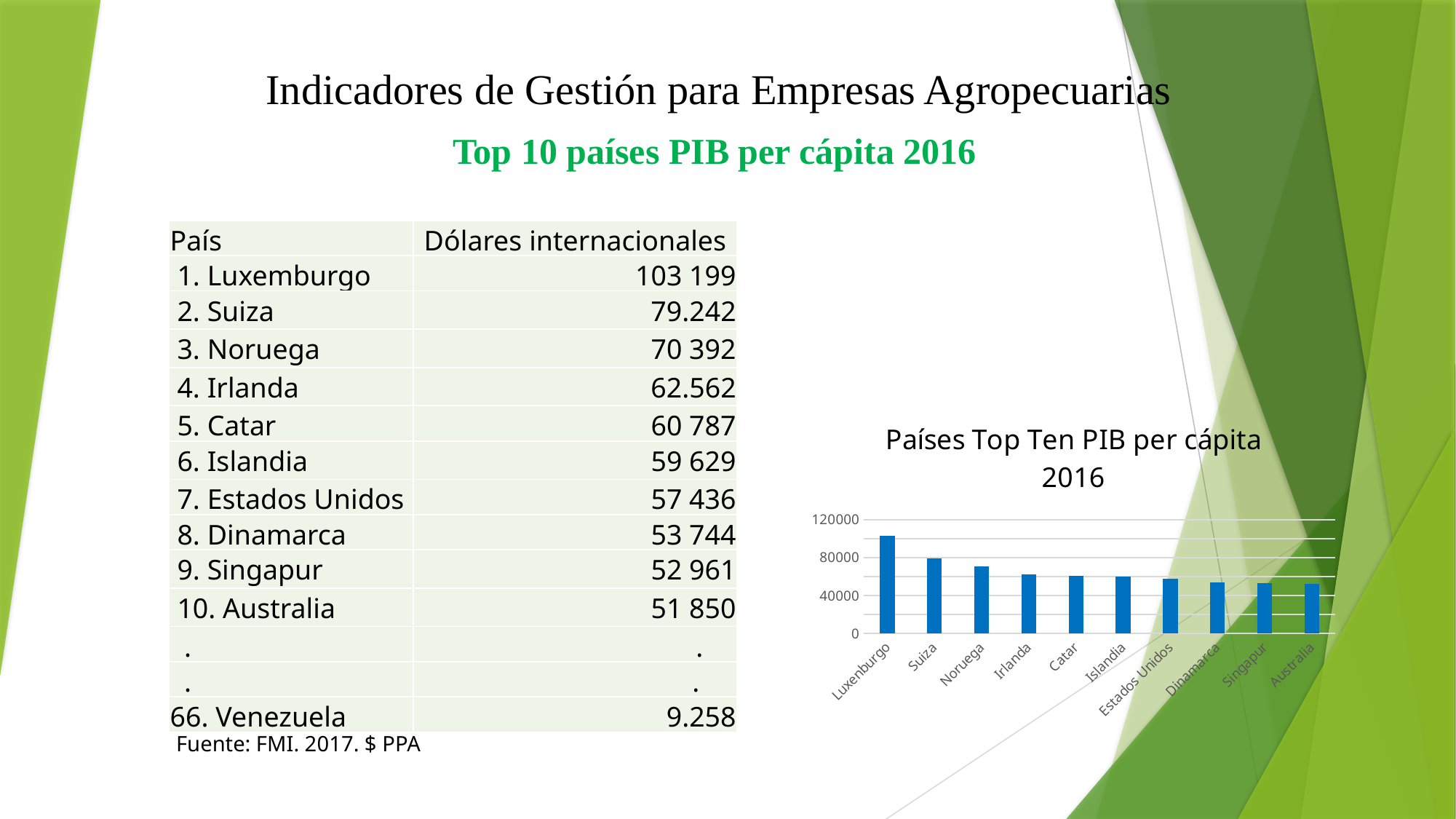
What is the title of the chart? Países Top Ten PIB per cápita 2016 Which country has the highest bar in the chart? Luxenburgo Which is larger in the chart, the value for Luxemburgo or the value for Suiza? Luxemburgo What kind of chart is shown on the slide? bar chart Which is larger in the chart, the value for Noruega or the value for Irlanda? Noruega Do the bar values rise or fall from left to right along the x axis? fall What colour are the bars in the chart? blue Is the value for Dinamarca greater or less than 80000? less How many countries are plotted in the chart? 10 Is the value for Luxemburgo greater or less than 80000? greater Is the value for Noruega greater or less than 80000? less